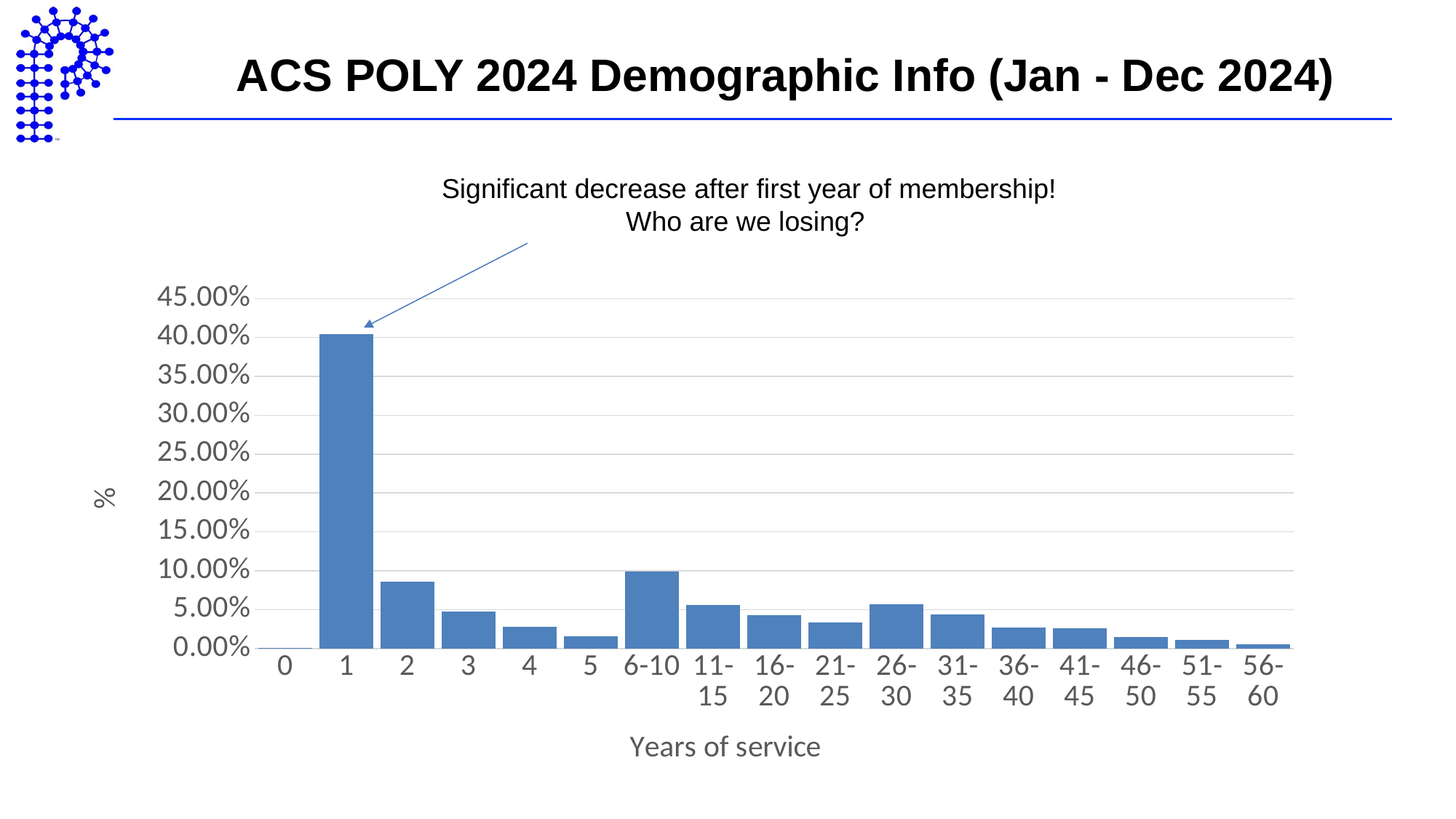
Which is larger, the value for 6-10 years of service or the value for 2 years of service? 6-10 What kind of chart is shown on the slide? bar chart Is the value for 1 year of service greater or less than 35.00%? greater Is the value for 21-25 years of service greater or less than 5.00%? less How many years-of-service categories are shown on the x axis? 17 Is the value for 2 years of service greater or less than 5.00%? greater Which is larger, the value for 3 years of service or the value for 4 years of service? 3 What is the title of the x axis? Years of service Which years-of-service category has the highest percentage? 1